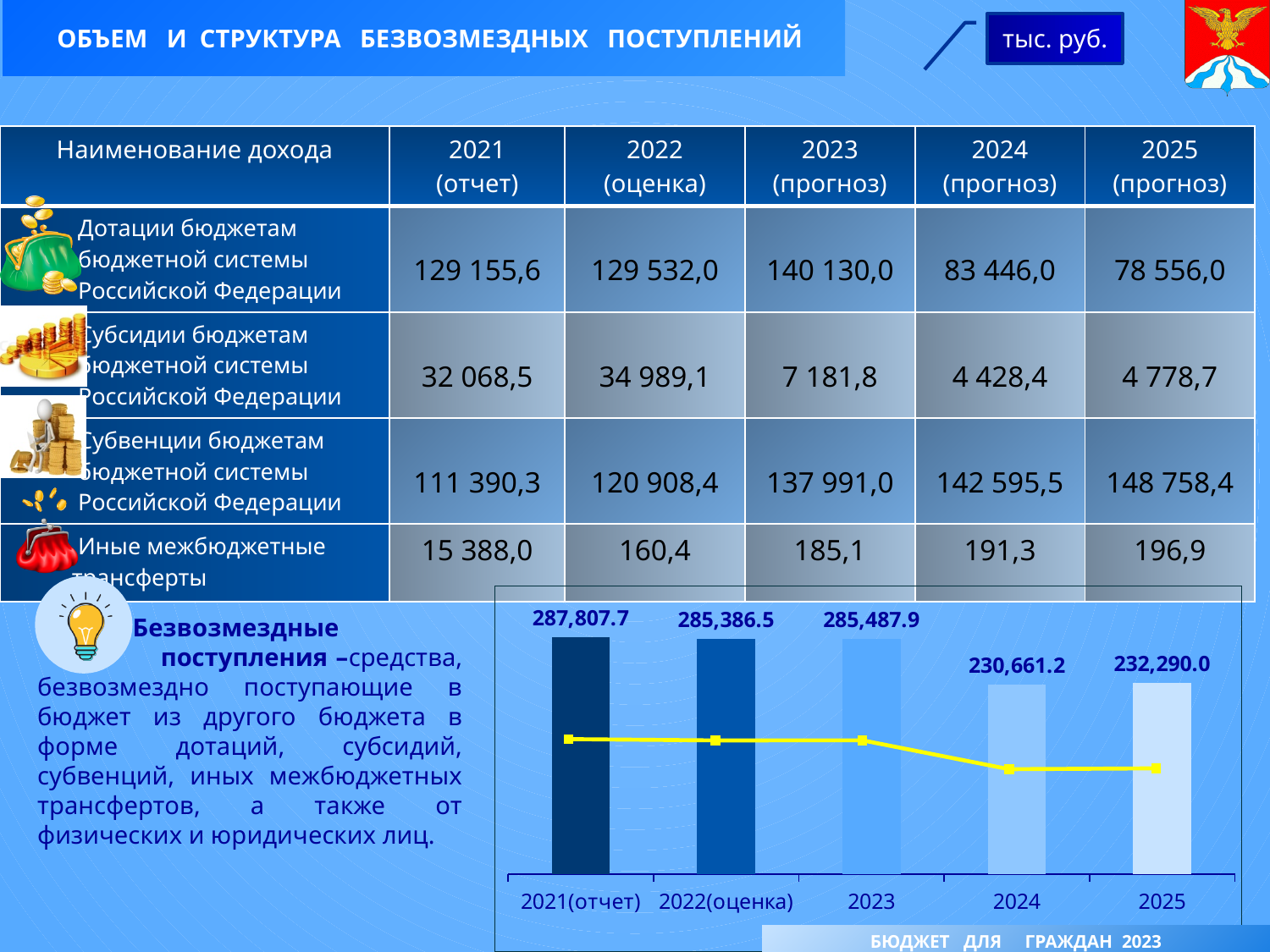
Which is larger in the chart, the value for 2023 or the value for 2025? 2023 What value is shown for 2022(оценка) in the chart? 285,386.5 What is the difference between the values for 2021(отчет) and 2024 in the chart? 57,146.5 What is the difference between the values for 2025 and 2024 in the chart? 1,628.8 How many categories are shown on the x axis of the chart? 5 What value is shown for 2024 in the chart? 230,661.2 What value is shown for 2021(отчет) in the chart? 287,807.7 What value is shown for 2025 in the chart? 232,290.0 What kind of chart is shown at the bottom of the slide? bar chart with a line Which category has the highest value in the chart? 2021(отчет) Do the values in the chart generally rise or fall from 2021(отчет) to 2025? fall Which category has the lowest value in the chart? 2024